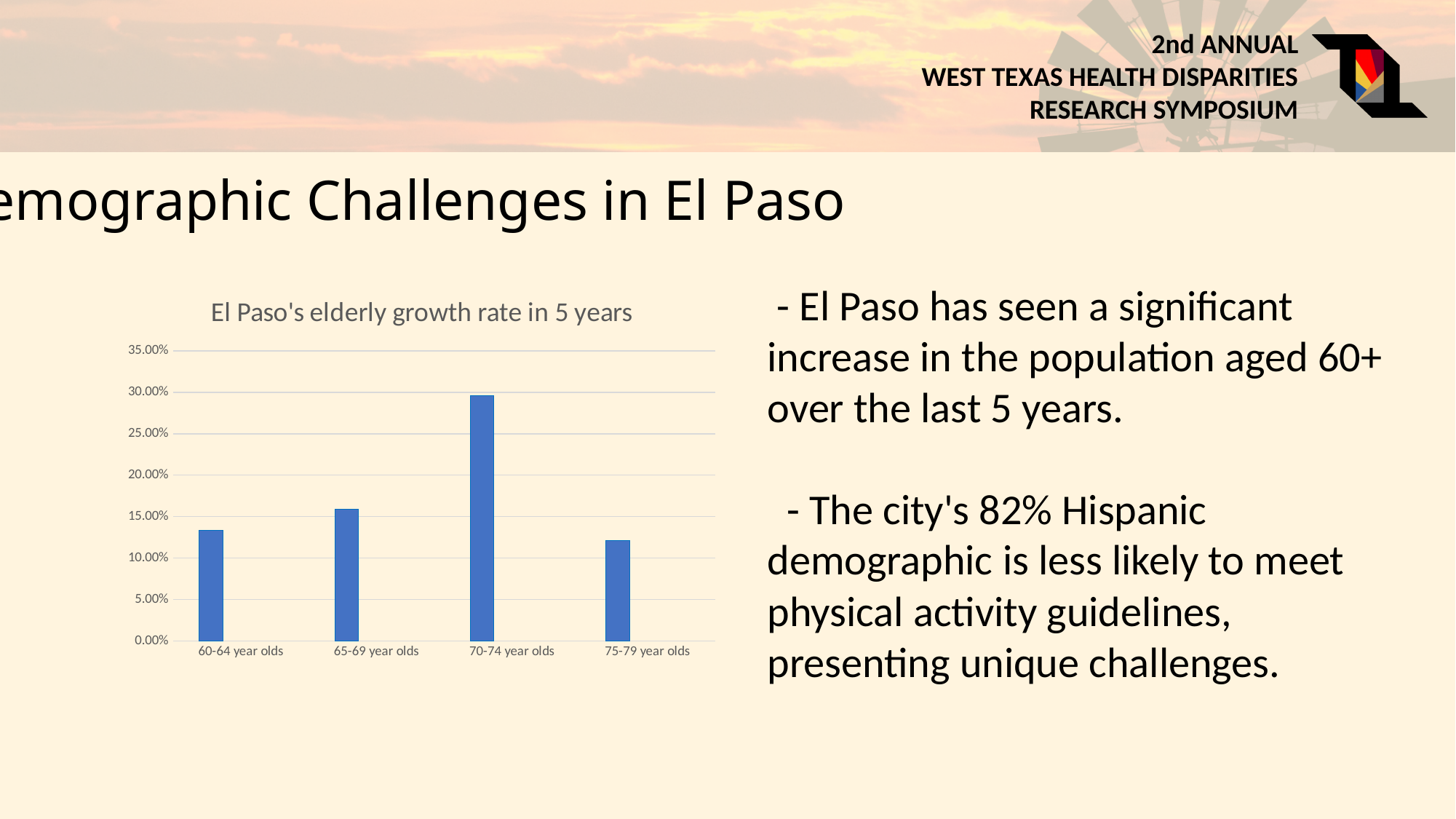
Is the value for 75-79 year olds greater or less than 15.00%? less Which is larger, the value for 60-64 year olds or the value for 65-69 year olds? 65-69 year olds What kind of chart is shown on the slide? bar chart Is the value for 60-64 year olds greater or less than 10.00%? greater Is the value for 70-74 year olds greater or less than 25.00%? greater Which is larger, the value for 70-74 year olds or the value for 75-79 year olds? 70-74 year olds What is the highest value shown on the chart's vertical axis? 35.00% Which age group has the highest growth rate in the chart? 70-74 year olds What is the title of the chart? El Paso's elderly growth rate in 5 years How many age groups are shown in the chart? 4 Which age group has the lowest growth rate in the chart? 75-79 year olds